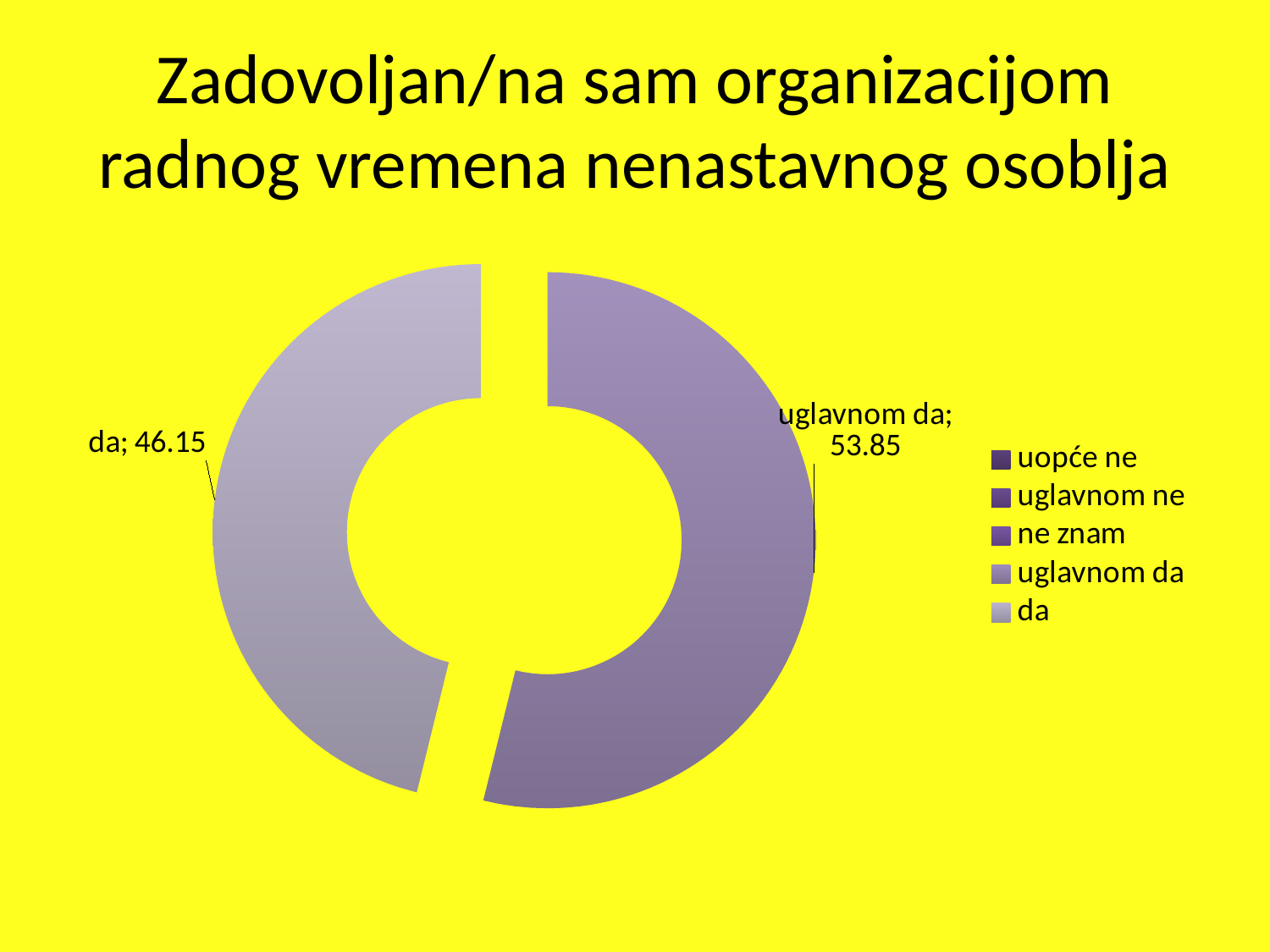
Is the value for "uglavnom da" greater or less than 50? greater What is the difference between the values for "uglavnom da" and "da"? 7.7 Is the value for "da" greater or less than 50? less Which of the two labelled categories has the smaller value? da What is the value shown for "da"? 46.15 What is the title of the slide? Zadovoljan/na sam organizacijom radnog vremena nenastavnog osoblja What is the value shown for "uglavnom da"? 53.85 Which category has the largest share of the chart? uglavnom da What kind of chart is shown on the slide? Doughnut (pie) chart How many categories does the legend list? 5 Which is larger, the value for "da" or the value for "uglavnom da"? uglavnom da How many slices with data labels are visible in the chart? 2